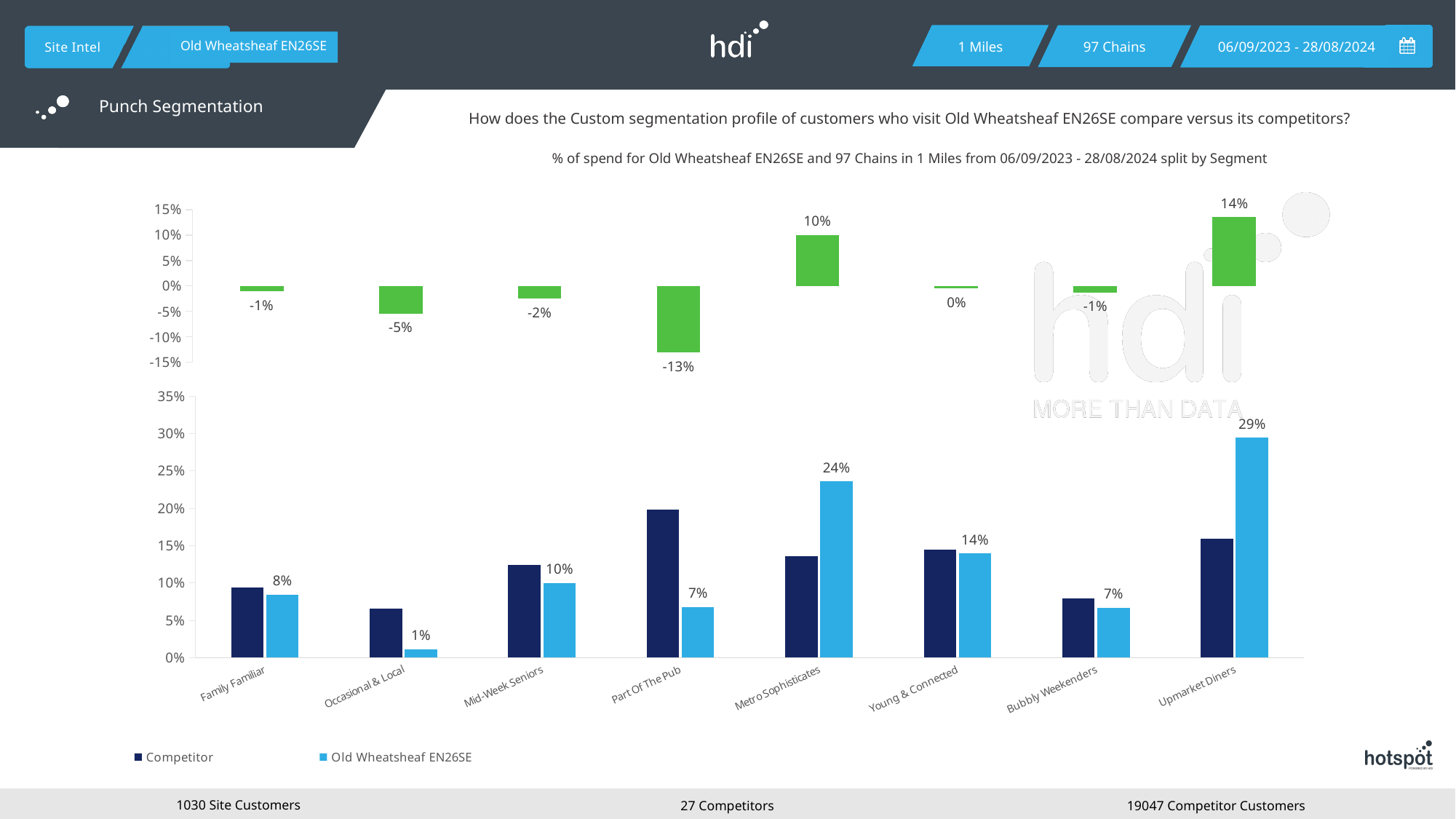
How many segments are shown on the x axis of the bottom chart? 8 How many series does the legend of the bottom chart list? 2 In the top chart, which segment has the highest value? Upmarket Diners In the top chart, which segment has the lowest value? Part Of The Pub In the bottom chart, which segment has the highest value for Old Wheatsheaf EN26SE? Upmarket Diners In the bottom chart, which segment has the lowest value for Old Wheatsheaf EN26SE? Occasional & Local In the bottom chart, is the Competitor value for Part Of The Pub greater or less than 15%? greater In the bottom chart, for Part Of The Pub, which series has the larger value: Competitor or Old Wheatsheaf EN26SE? Competitor In the bottom chart, what is the value for Old Wheatsheaf EN26SE in the Metro Sophisticates segment? 24% What kind of chart is the bottom chart? Bar chart In the top chart, what is the value shown for Part Of The Pub? -13% In the bottom chart, what is the difference between the Old Wheatsheaf EN26SE values for Upmarket Diners and Metro Sophisticates? 5%